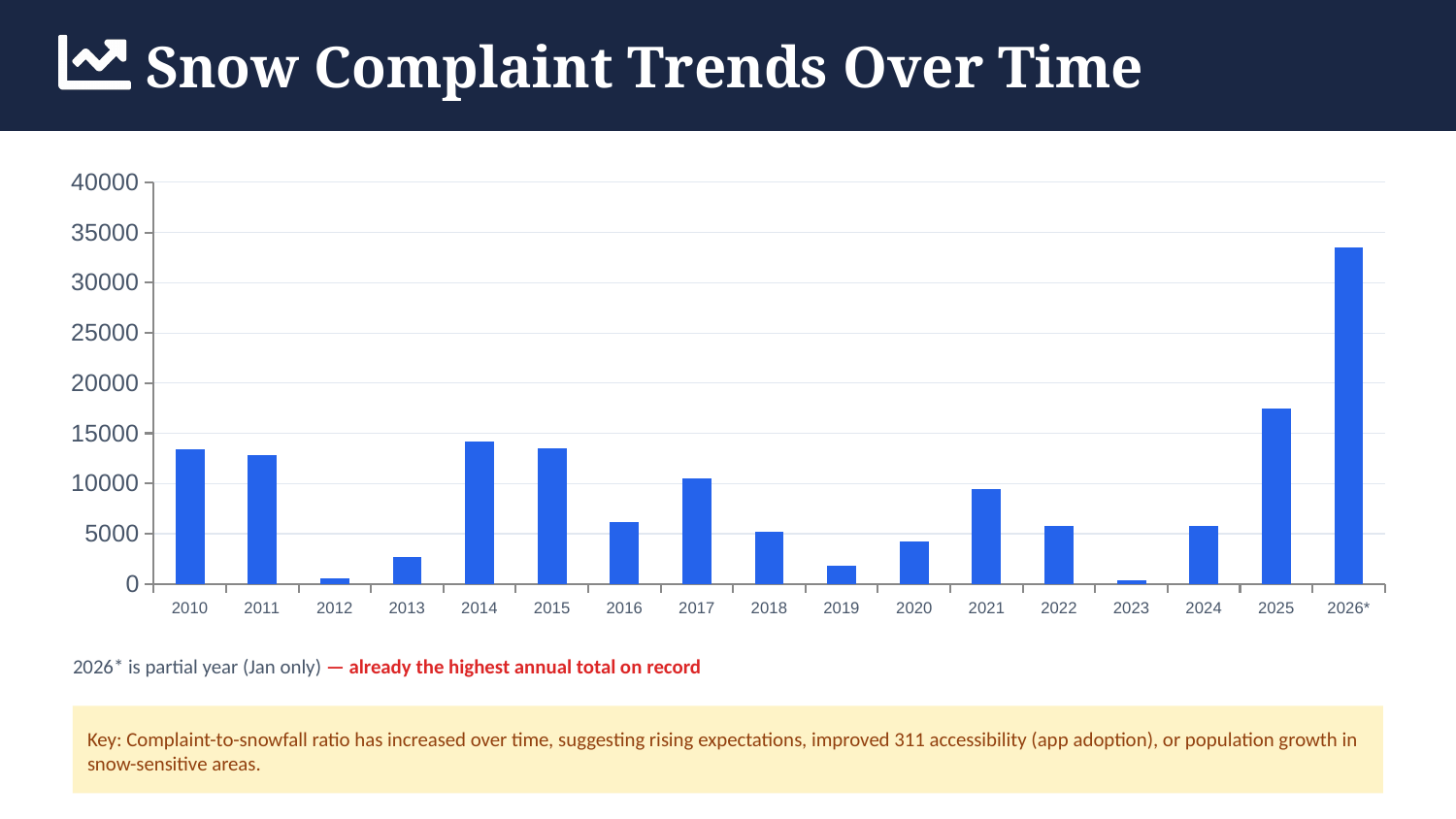
Is the value for 2012 greater or less than 5000? less Which is larger, the value for 2025 or the value for 2010? 2025 Is the value for 2021 greater or less than 10000? less What is the title of the chart? Snow Complaint Trends Over Time What kind of chart is shown on the slide? bar chart Is the value for 2025 greater or less than 15000? greater Which is larger, the value for 2014 or the value for 2016? 2014 Do the values rise or fall from 2021 to 2023? fall How many years are shown on the x axis of the chart? 17 Which year has the highest number of snow complaints? 2026*